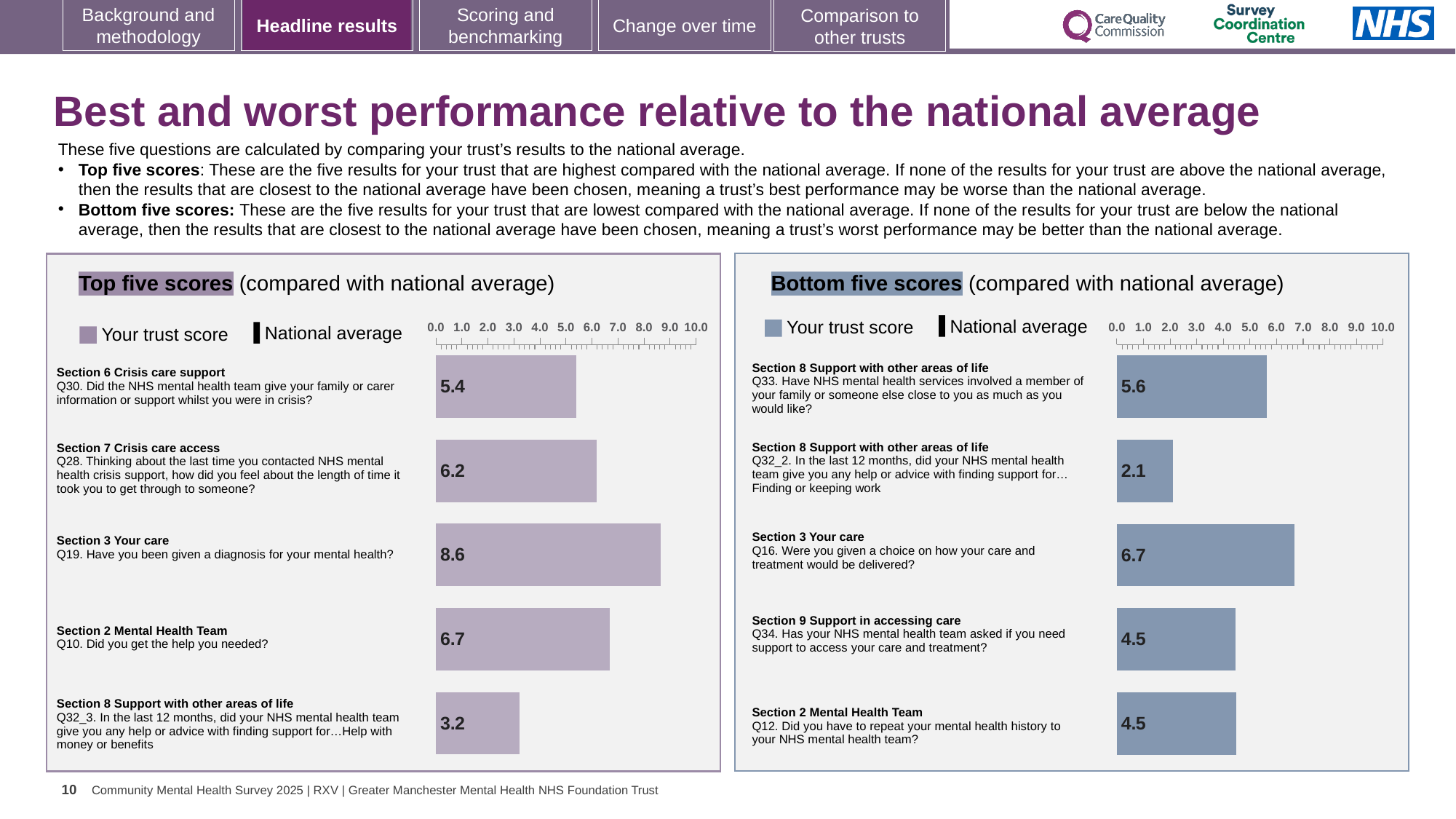
In the Top five scores chart, which has the larger trust score: Q28 or Q10? Q10 How many questions are plotted in the Bottom five scores chart? 5 In the Bottom five scores chart, which question has the lowest trust score? Q32_2 (finding or keeping work) In the Top five scores chart, what is the trust score for Q19 (Have you been given a diagnosis for your mental health?)? 8.6 In the Top five scores chart, what is the difference between the trust scores for Q19 and Q30? 3.2 What type of chart is the Top five scores chart? Bar chart In the Bottom five scores chart, what is the trust score for Q32_2 (help or advice with finding support for finding or keeping work)? 2.1 In the Top five scores chart, which question has the highest trust score? Q19. Have you been given a diagnosis for your mental health? In the Bottom five scores chart, what is the trust score for Q16 (Were you given a choice on how your care and treatment would be delivered?)? 6.7 In the Bottom five scores chart, what is the difference between the trust scores for Q16 and Q32_2? 4.6 How many entries does the legend of the Top five scores chart list? 2 In the Top five scores chart, what is the trust score for Q32_3 (help or advice with finding support for money or benefits)? 3.2